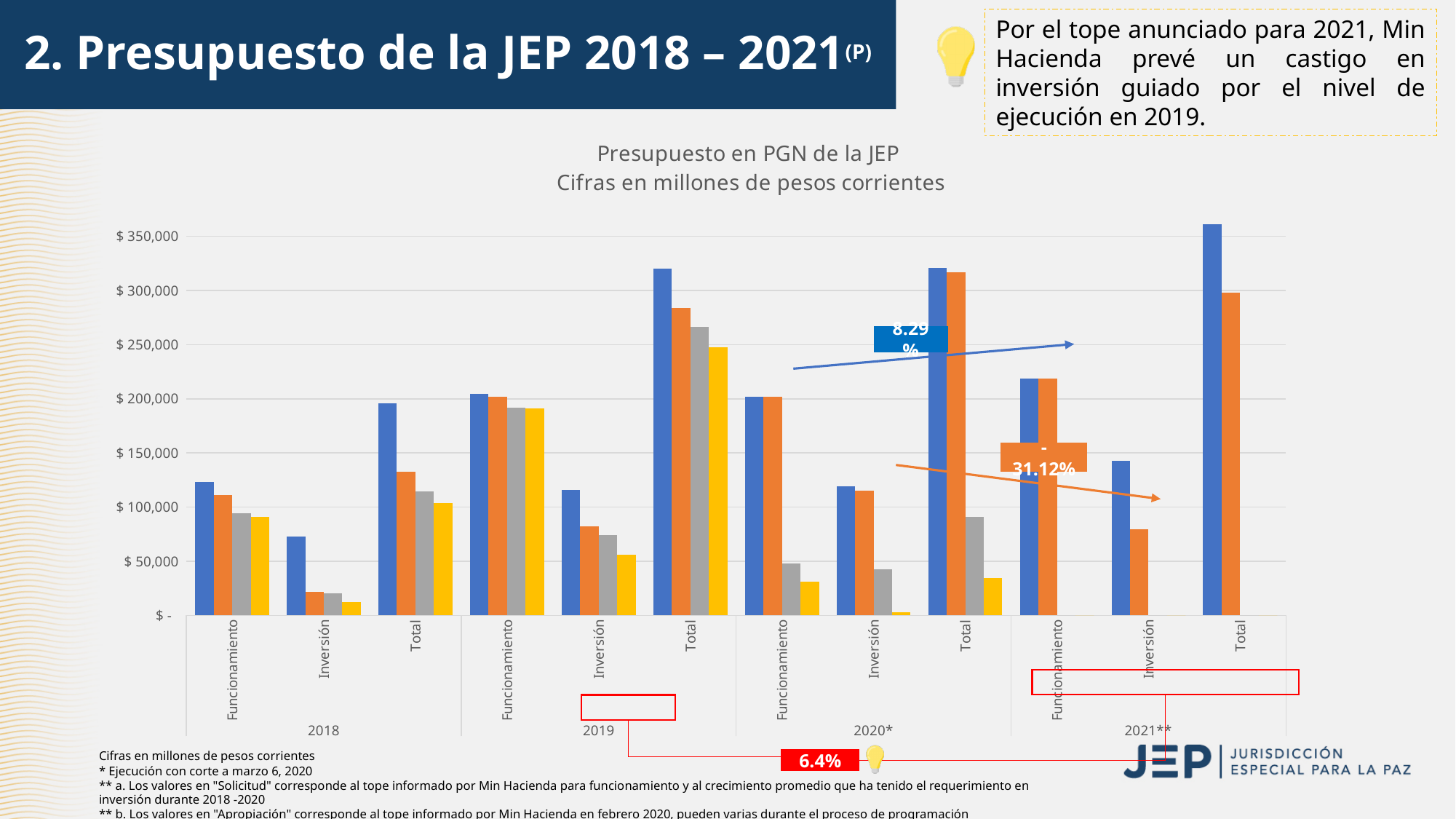
How many category groups (Funcionamiento/Inversión/Total across all years) are shown on the x axis? 12 What kind of chart is shown on the slide? bar chart Do the blue Total bars rise or fall from 2018 to 2021**? rise Is the blue bar for Funcionamiento in 2018 greater or less than $ 100,000? greater Is the orange bar for Total in 2018 greater or less than $ 150,000? less What is the title of the chart? Presupuesto en PGN de la JEP Is the yellow bar for Inversión in 2018 greater or less than $ 50,000? less Which is larger: the blue Total bar for 2021** or the blue Total bar for 2018? 2021** Which year has the tallest blue bar for Total? 2021** In what units are the chart's figures expressed, according to the chart subtitle? millones de pesos corrientes